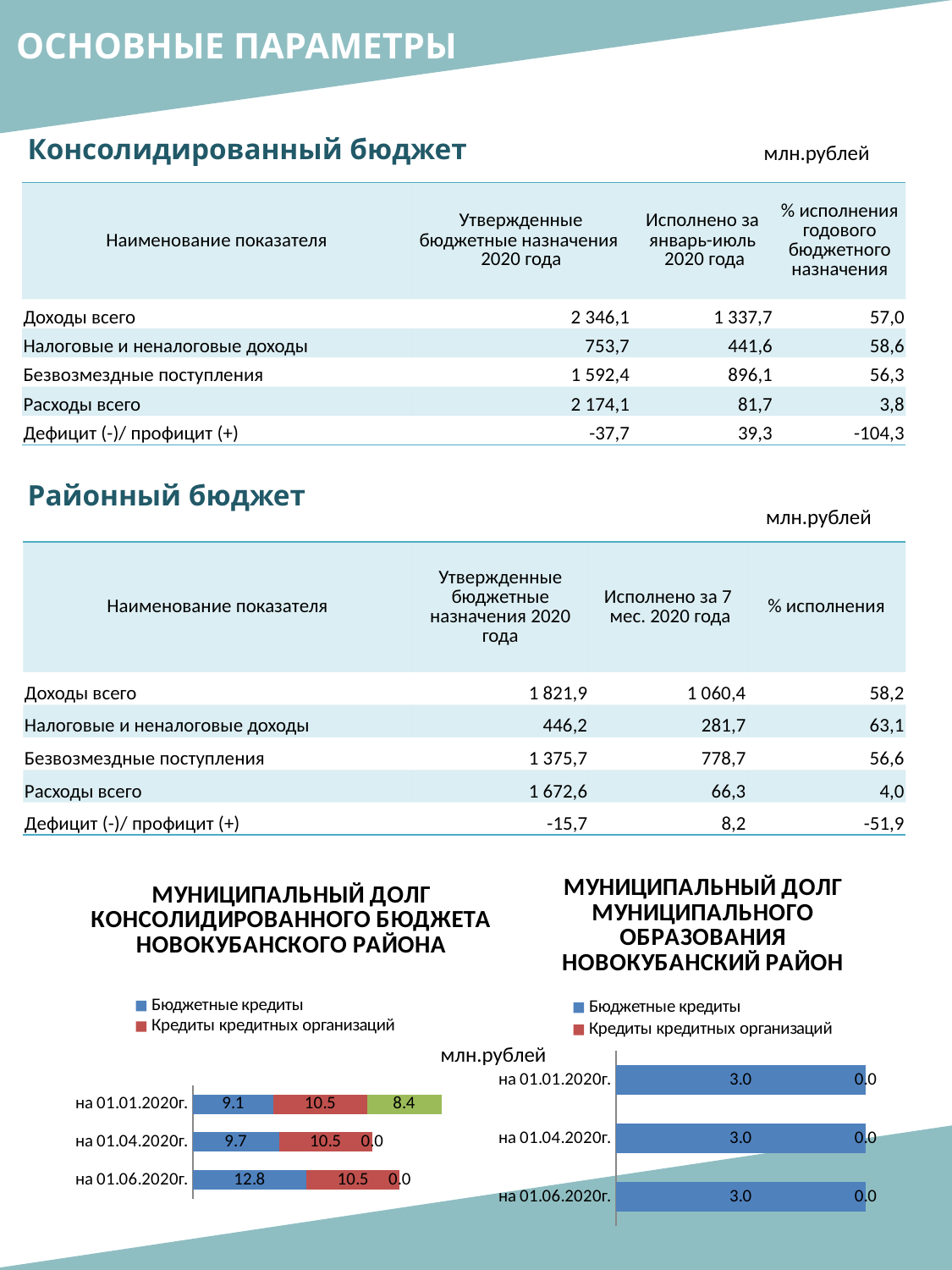
In the chart titled 'МУНИЦИПАЛЬНЫЙ ДОЛГ КОНСОЛИДИРОВАННОГО БЮДЖЕТА НОВОКУБАНСКОГО РАЙОНА', which date has the lowest value for 'Бюджетные кредиты'? на 01.01.2020г. In the chart titled 'МУНИЦИПАЛЬНЫЙ ДОЛГ КОНСОЛИДИРОВАННОГО БЮДЖЕТА НОВОКУБАНСКОГО РАЙОНА', which date has the highest value for 'Бюджетные кредиты'? на 01.06.2020г. In the chart titled 'МУНИЦИПАЛЬНЫЙ ДОЛГ КОНСОЛИДИРОВАННОГО БЮДЖЕТА НОВОКУБАНСКОГО РАЙОНА', does the 'Бюджетные кредиты' value rise or fall from 'на 01.01.2020г.' to 'на 01.06.2020г.'? rise What type of chart is the one titled 'МУНИЦИПАЛЬНЫЙ ДОЛГ МУНИЦИПАЛЬНОГО ОБРАЗОВАНИЯ НОВОКУБАНСКИЙ РАЙОН'? bar chart In the chart titled 'МУНИЦИПАЛЬНЫЙ ДОЛГ КОНСОЛИДИРОВАННОГО БЮДЖЕТА НОВОКУБАНСКОГО РАЙОНА', what is the value of 'Кредиты кредитных организаций' for 'на 01.04.2020г.'? 10.5 In the chart titled 'МУНИЦИПАЛЬНЫЙ ДОЛГ МУНИЦИПАЛЬНОГО ОБРАЗОВАНИЯ НОВОКУБАНСКИЙ РАЙОН', how many series does the legend list? 2 In the chart titled 'МУНИЦИПАЛЬНЫЙ ДОЛГ МУНИЦИПАЛЬНОГО ОБРАЗОВАНИЯ НОВОКУБАНСКИЙ РАЙОН', what is the value of 'Бюджетные кредиты' for 'на 01.04.2020г.'? 3.0 In the chart titled 'МУНИЦИПАЛЬНЫЙ ДОЛГ КОНСОЛИДИРОВАННОГО БЮДЖЕТА НОВОКУБАНСКОГО РАЙОНА', what is the value of 'Бюджетные кредиты' for 'на 01.06.2020г.'? 12.8 In the chart titled 'МУНИЦИПАЛЬНЫЙ ДОЛГ КОНСОЛИДИРОВАННОГО БЮДЖЕТА НОВОКУБАНСКОГО РАЙОНА', what is the difference between the 'Бюджетные кредиты' values for 'на 01.06.2020г.' and 'на 01.01.2020г.'? 3.7 In the chart titled 'МУНИЦИПАЛЬНЫЙ ДОЛГ КОНСОЛИДИРОВАННОГО БЮДЖЕТА НОВОКУБАНСКОГО РАЙОНА', what is the total of the stacked bar for 'на 01.06.2020г.'? 23.3 In the chart titled 'МУНИЦИПАЛЬНЫЙ ДОЛГ КОНСОЛИДИРОВАННОГО БЮДЖЕТА НОВОКУБАНСКОГО РАЙОНА', how many dates (categories) are shown? 3 In the chart titled 'МУНИЦИПАЛЬНЫЙ ДОЛГ МУНИЦИПАЛЬНОГО ОБРАЗОВАНИЯ НОВОКУБАНСКИЙ РАЙОН', what is the value of 'Кредиты кредитных организаций' for 'на 01.06.2020г.'? 0.0